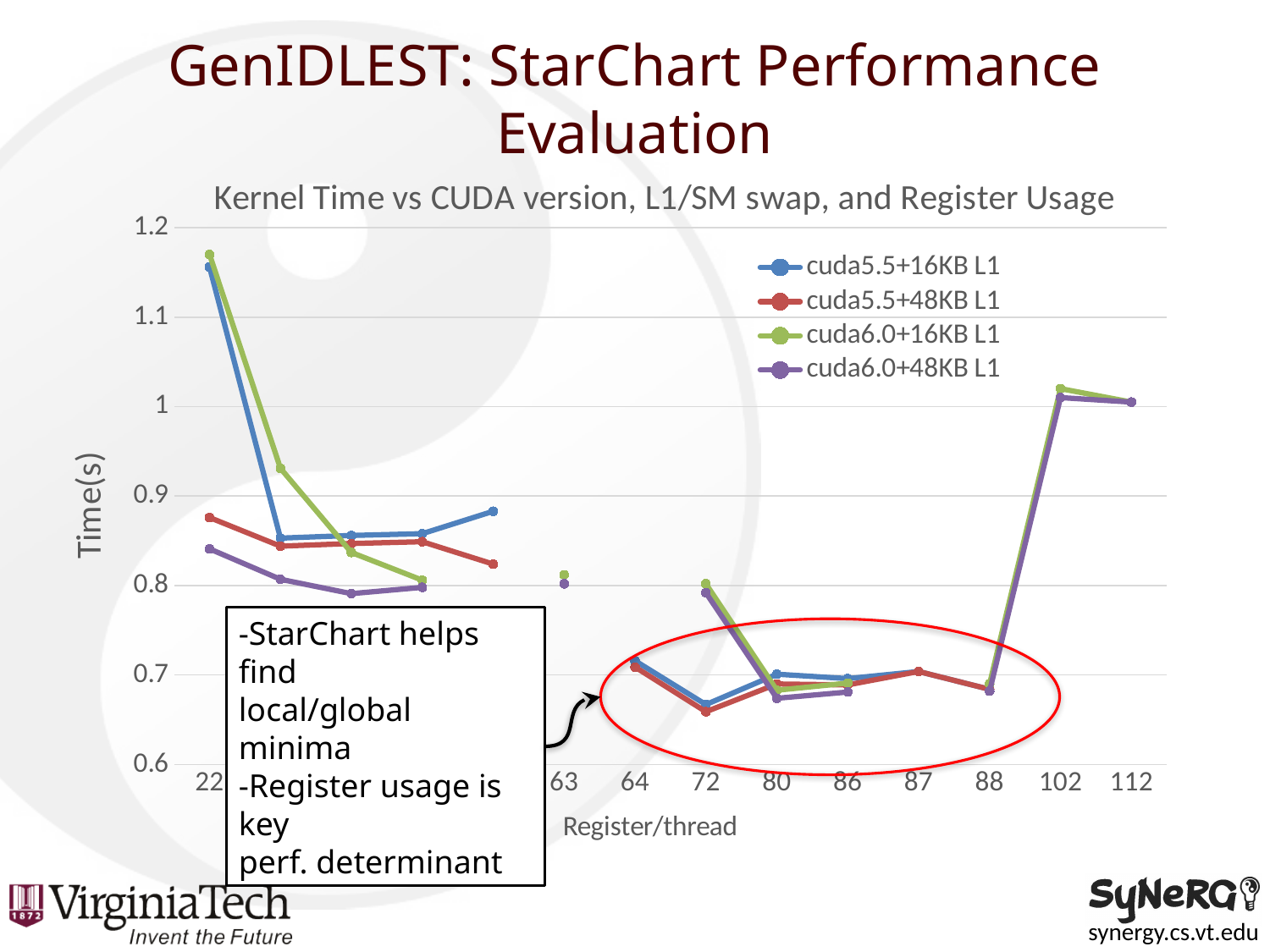
Is the value for cuda6.0+16KB L1 at 102 registers/thread greater or less than 1? greater Is the value for cuda6.0+16KB L1 at 22 registers/thread greater or less than 1.1? greater Is the value for cuda6.0+48KB L1 at 22 registers/thread greater or less than 0.9? less At which register/thread value does the cuda5.5+48KB L1 series reach its lowest point? 72 At 22 registers/thread, which is larger: the value for cuda5.5+16KB L1 or the value for cuda6.0+48KB L1? cuda5.5+16KB L1 How many series does the chart legend list? 4 What is the title of the chart? Kernel Time vs CUDA version, L1/SM swap, and Register Usage What is the label of the x axis of the chart? Register/thread Does the cuda5.5+16KB L1 series rise or fall from 22 to 72 registers/thread? fall What kind of chart is shown on the slide? line chart